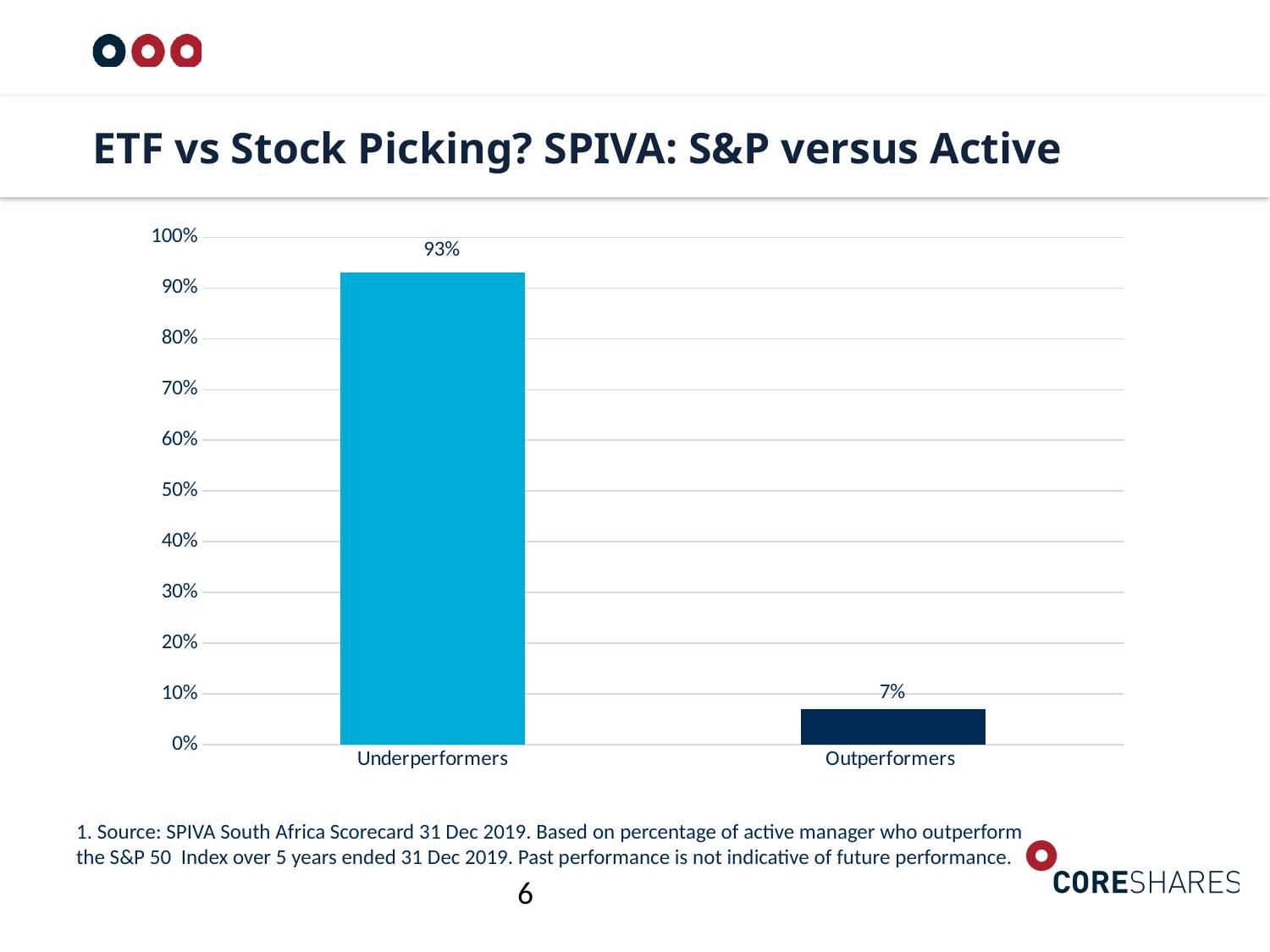
What is the value for Outperformers? 7% Is the value for Outperformers greater or less than 10%? less What kind of chart is shown on the slide? Bar chart Is the value for Underperformers greater or less than 90%? greater What is the total of the two values shown in the chart? 100% What is the maximum value shown on the y axis? 100% Which category has the lowest value? Outperformers What is the difference between the values for Underperformers and Outperformers? 86% How many categories are shown on the x axis? 2 Which is larger, the value for Underperformers or the value for Outperformers? Underperformers What is the value for Underperformers? 93% Which category has the highest value? Underperformers